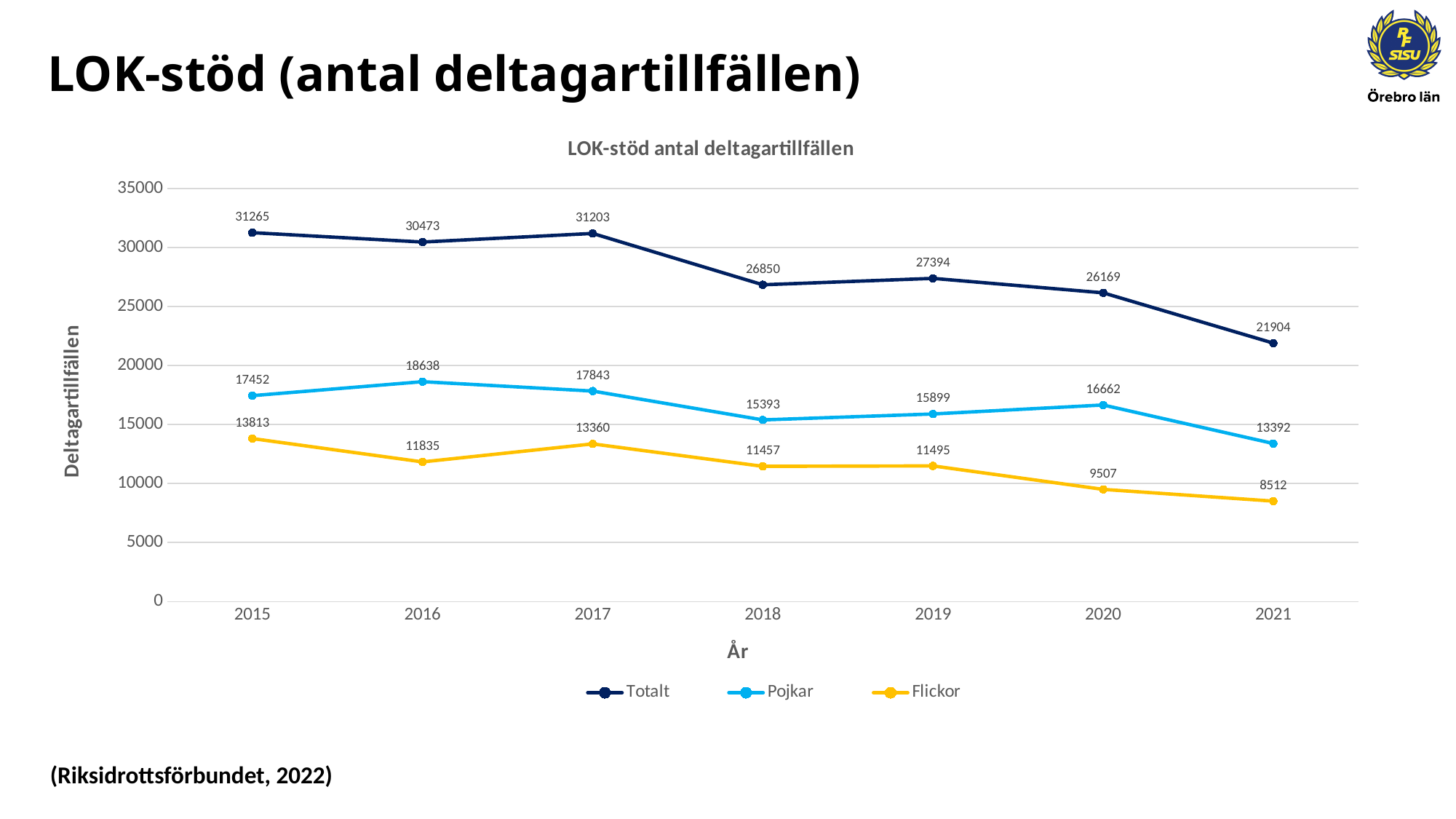
How many series does the legend list? 3 Is the value for Totalt in 2018 greater or less than 25000? greater What is the value for Pojkar in 2018? 15393 How many years are shown on the x axis? 7 What is the difference between Pojkar and Flickor in 2020? 7155 What kind of chart is shown on the slide? line chart Does the Totalt series rise or fall from 2019 to 2021? fall What is the value for Totalt in 2015? 31265 In which year is the Pojkar series highest? 2016 What is the value for Flickor in 2021? 8512 In which year is the Totalt series lowest? 2021 Which is larger, Flickor in 2017 or Flickor in 2019? Flickor in 2017